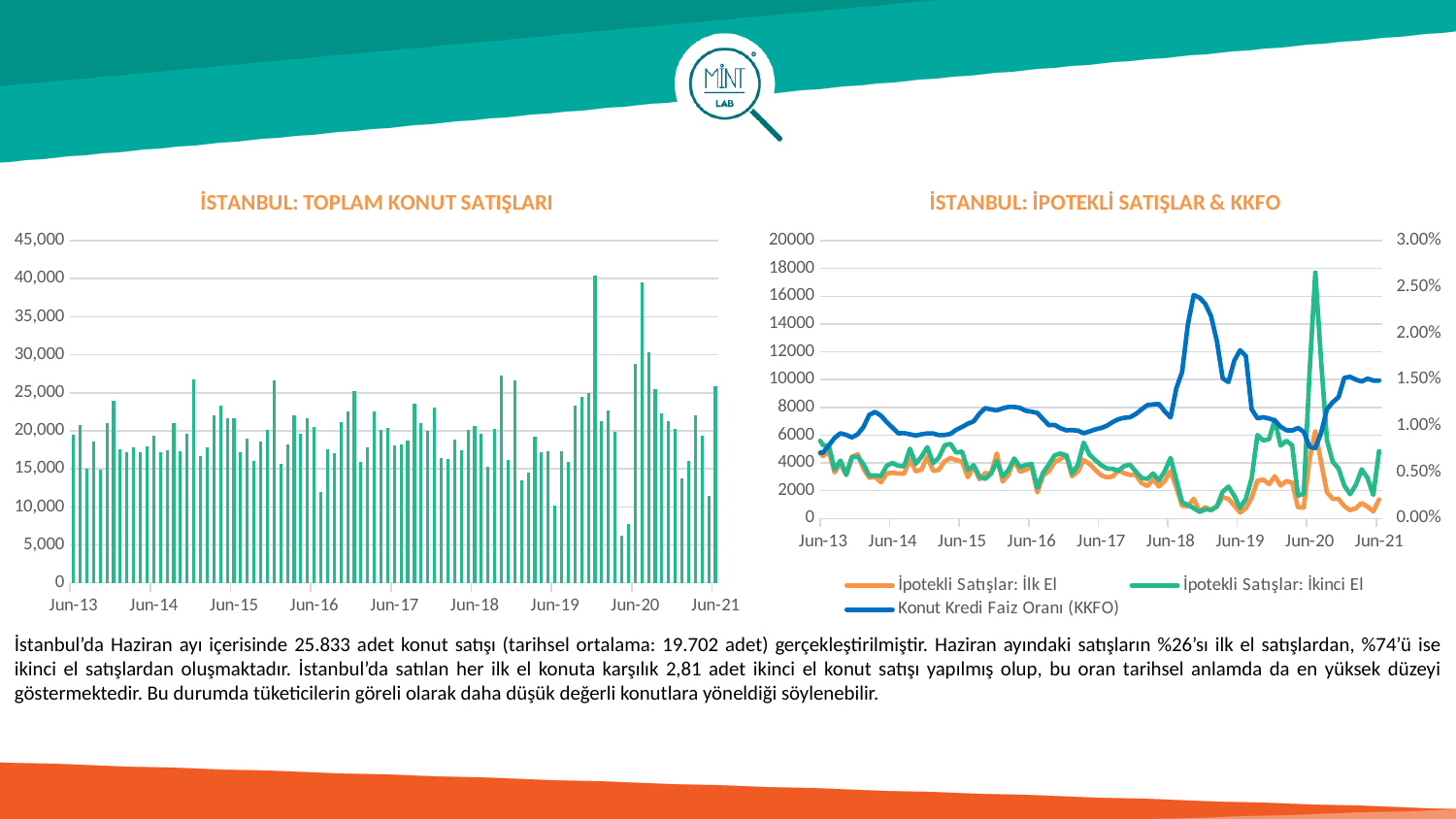
In the left chart, 'İSTANBUL: TOPLAM KONUT SATIŞLARI', is the value for Jun-13 greater or less than 25,000? less In the right chart, 'İSTANBUL: İPOTEKLİ SATIŞLAR & KKFO', is the peak value of 'İpotekli Satışlar: İkinci El' greater or less than 16000? greater In the right chart, 'İSTANBUL: İPOTEKLİ SATIŞLAR & KKFO', is the peak value of 'Konut Kredi Faiz Oranı (KKFO)' greater or less than 2.00%? greater How many year labels (Jun-13 through Jun-21) are shown on the x axis of the left chart, 'İSTANBUL: TOPLAM KONUT SATIŞLARI'? 9 How many series does the legend of the right chart, 'İSTANBUL: İPOTEKLİ SATIŞLAR & KKFO', list? 3 In the right chart, 'İSTANBUL: İPOTEKLİ SATIŞLAR & KKFO', which series is plotted against the right-hand percentage axis? Konut Kredi Faiz Oranı (KKFO) In the right chart, 'İSTANBUL: İPOTEKLİ SATIŞLAR & KKFO', which series reaches a higher value around Jun-20: 'İpotekli Satışlar: İlk El' or 'İpotekli Satışlar: İkinci El'? İpotekli Satışlar: İkinci El In the right chart, 'İSTANBUL: İPOTEKLİ SATIŞLAR & KKFO', does 'Konut Kredi Faiz Oranı (KKFO)' generally rise or fall between Jun-13 and Jun-18? rise In the left chart, 'İSTANBUL: TOPLAM KONUT SATIŞLARI', what is the highest value shown on the vertical axis? 45,000 What kind of chart is the left chart, 'İSTANBUL: TOPLAM KONUT SATIŞLARI'? Bar chart What kind of chart is the right chart, 'İSTANBUL: İPOTEKLİ SATIŞLAR & KKFO'? Line chart